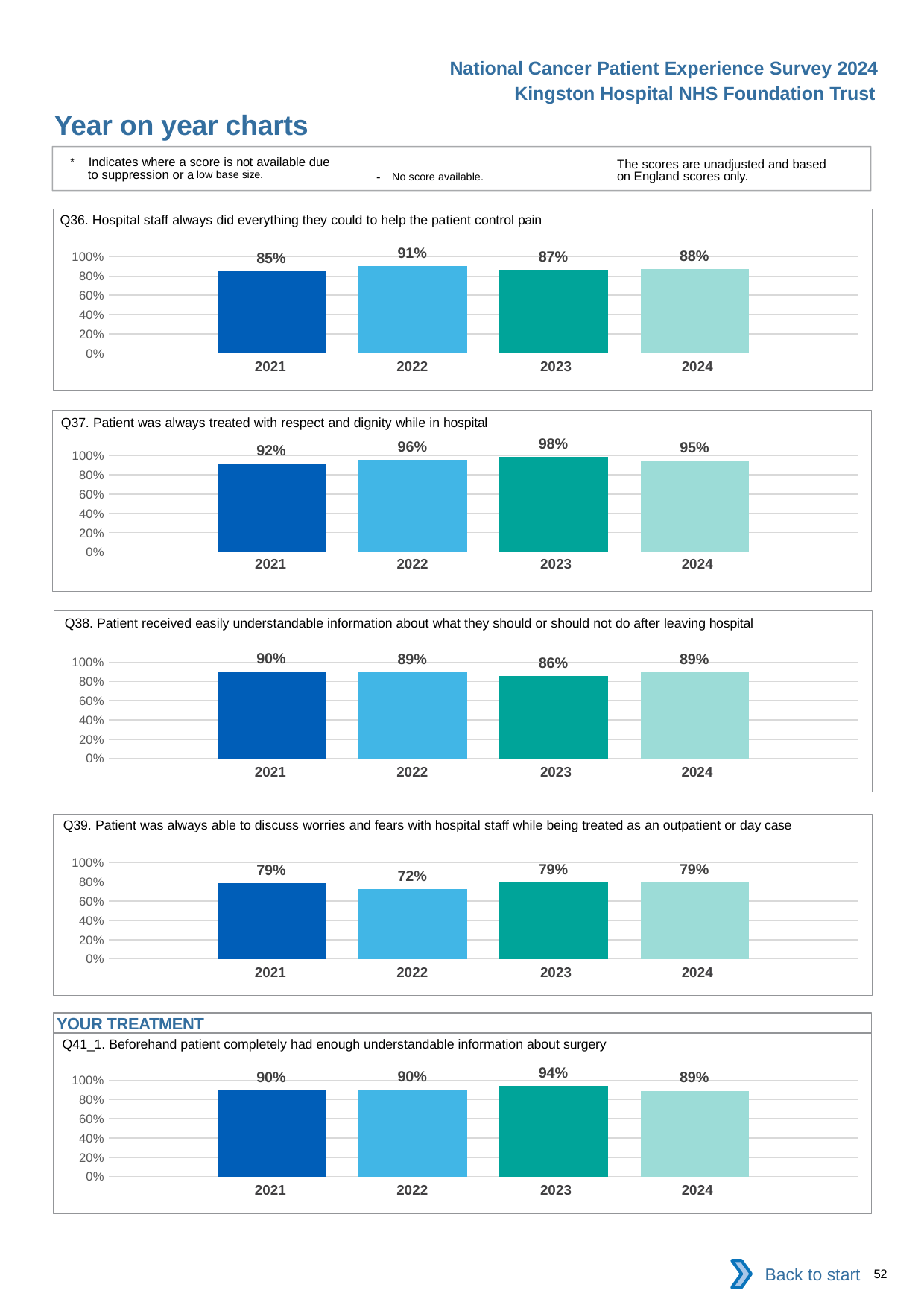
In the Q37 chart, what is the difference between the 2023 and 2021 values? 6 percentage points In the Q38 chart, what is the value for 2024? 89% How many years are shown in the Q36 chart? 4 In the Q41_1 chart, what is the value for 2023? 94% In the Q36 chart, what is the value for 2022? 91% In the Q39 chart, is the value for 2021 larger or smaller than the value for 2022? larger In the Q37 chart, which year has the highest value? 2023 In the Q41_1 chart, what is the difference between the 2023 and 2024 values? 5 percentage points In the Q36 chart, is the value for 2021 greater or less than 80%? greater In the Q39 chart, which year has the lowest value? 2022 In the Q38 chart, which year has the lowest value? 2023 What kind of chart is the Q37 chart? bar chart